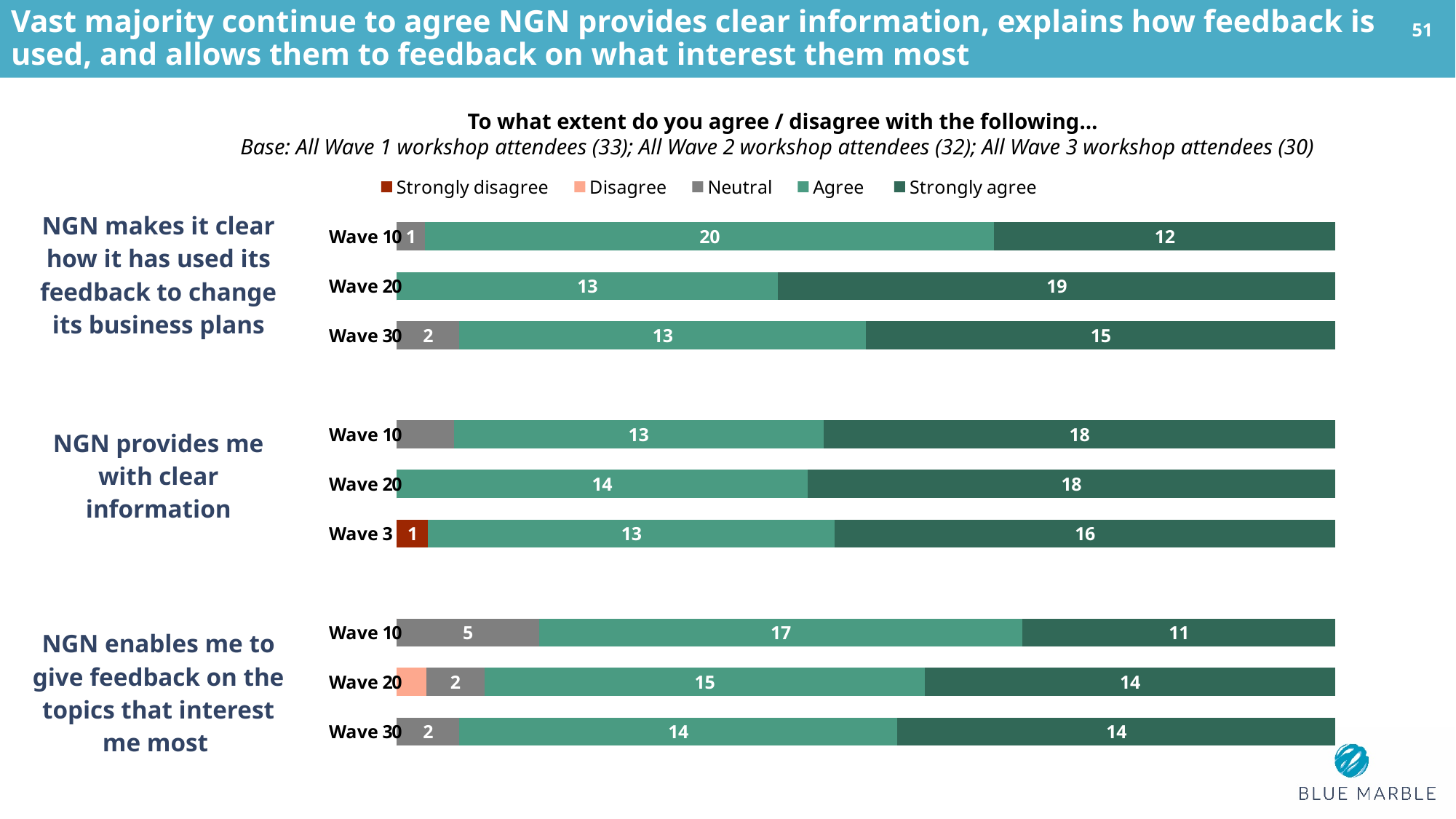
In the 'NGN provides me with clear information' chart, how many Wave 3 attendees answered Strongly disagree? 1 In the 'NGN makes it clear how it has used its feedback to change its business plans' chart, how many Wave 1 attendees answered Agree? 20 In the 'NGN enables me to give feedback on the topics that interest me most' chart, what is the total of the labelled Wave 3 segments (Neutral, Agree, Strongly agree)? 30 How many series does the legend list? 5 In the 'NGN makes it clear how it has used its feedback to change its business plans' chart, how many Wave 2 attendees answered Strongly agree? 19 In the 'NGN enables me to give feedback on the topics that interest me most' chart, how many Wave 1 attendees answered Neutral? 5 In the 'NGN provides me with clear information' chart, is the Strongly agree count for Wave 2 larger or smaller than for Wave 3? larger In the 'NGN enables me to give feedback on the topics that interest me most' chart, which wave has the highest Agree count? Wave 1 In the 'NGN makes it clear how it has used its feedback to change its business plans' chart, what is the difference between the Agree counts for Wave 1 and Wave 2? 7 What kind of chart is used on this slide? Stacked bar chart How many waves are shown in each chart? 3 In the 'NGN makes it clear how it has used its feedback to change its business plans' chart, which wave has the lowest Strongly agree count? Wave 1